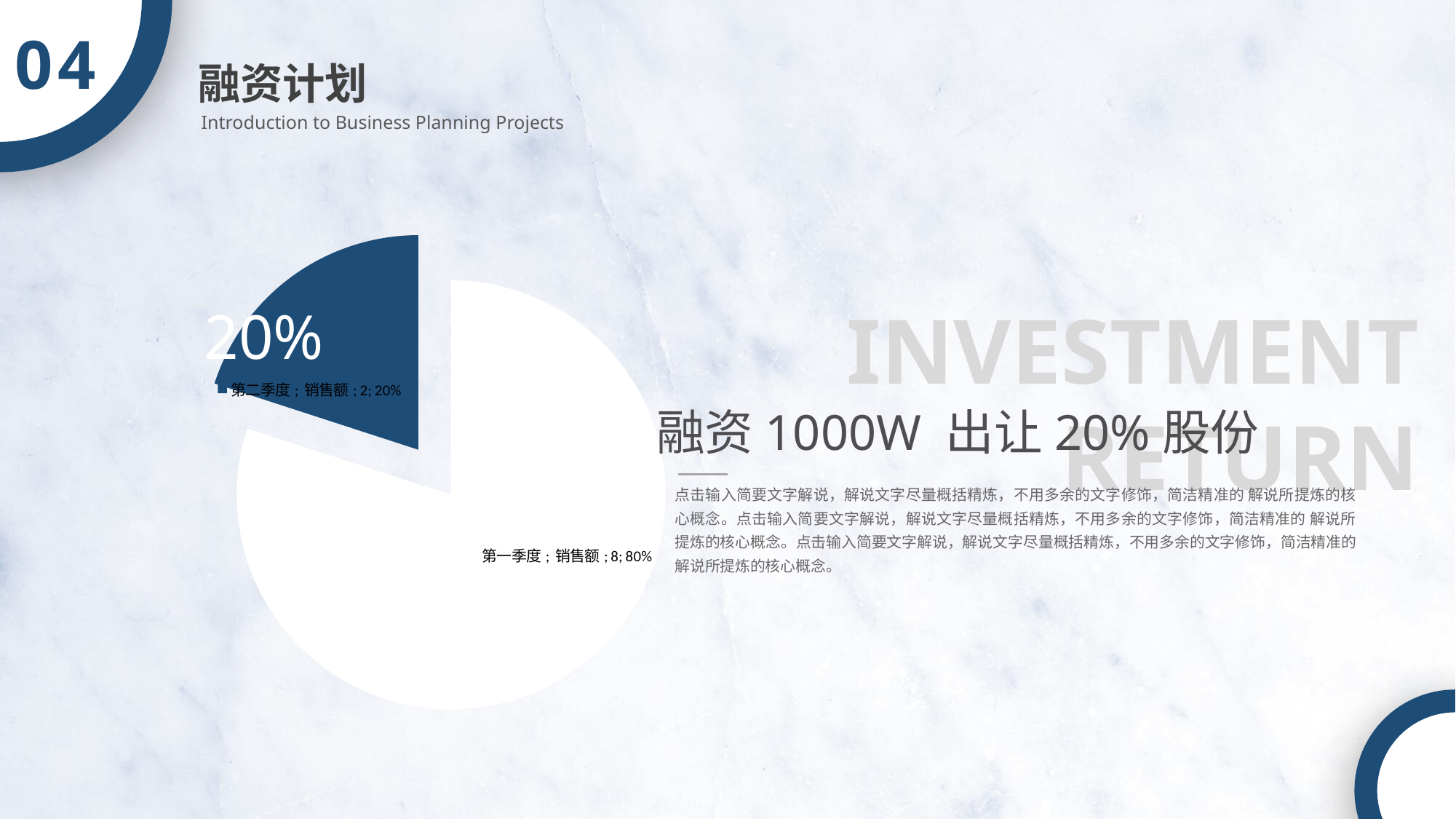
What share of the pie does 第二季度 represent? 20% What is the difference between the values for 第一季度 and 第二季度? 6 Which category has the smallest slice in the pie chart? 第二季度 Which category has the largest slice in the pie chart? 第一季度 How many slices does the pie chart have? 2 What kind of chart is shown on the slide? pie chart What series name is shown in the pie chart's data labels? 销售额 What share of the pie does 第一季度 represent? 80% What is the value for 第二季度 in the pie chart? 2 What is the total of the two values in the pie chart? 10 Which is larger, the value for 第一季度 or the value for 第二季度? 第一季度 What is the value for 第一季度 in the pie chart? 8